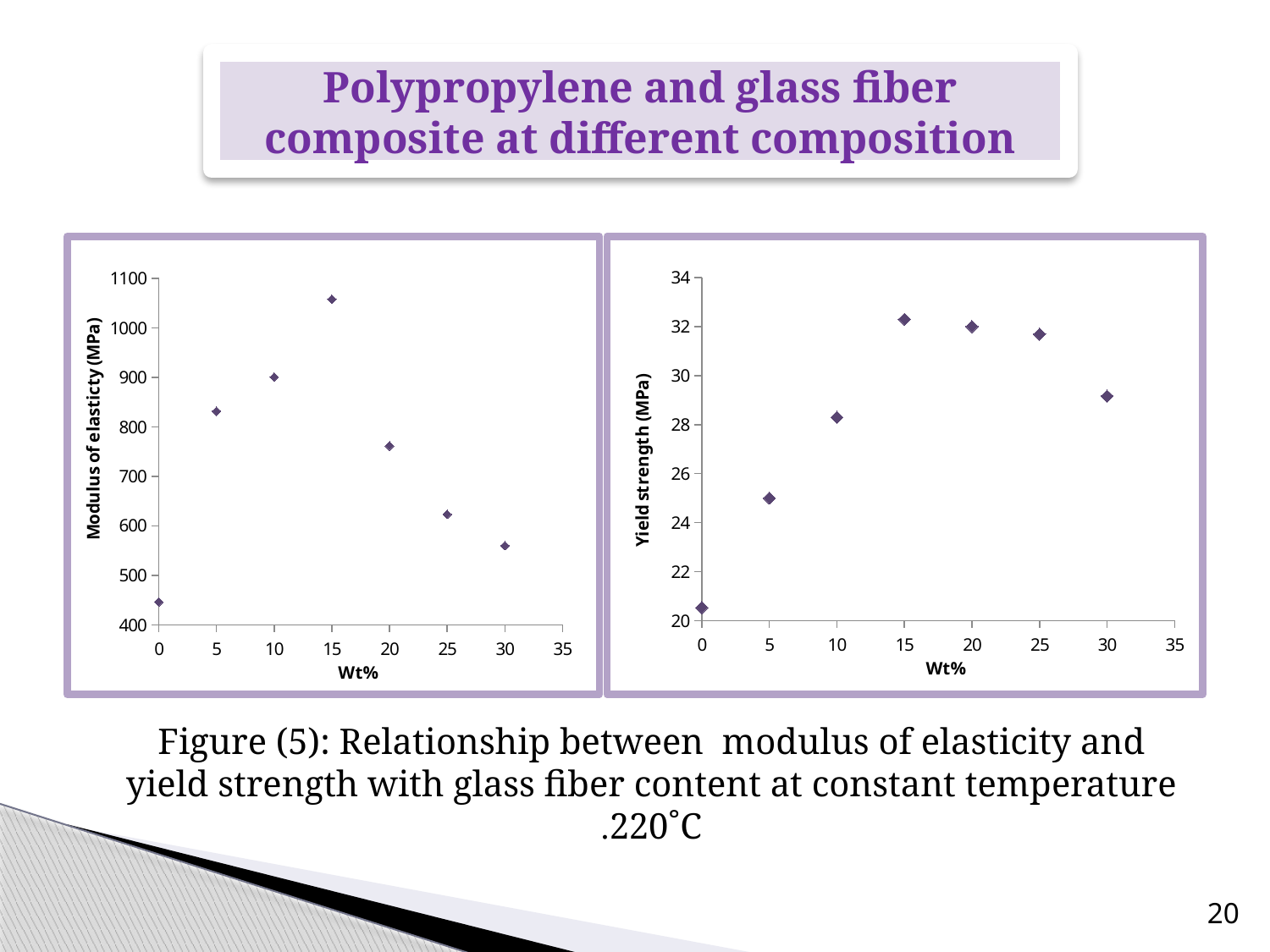
What is the y-axis label of the right chart? Yield strength (MPa) On the right chart (Yield strength vs Wt%), is the yield strength at 10 Wt% greater or less than 28? greater On the left chart (Modulus of elasticity vs Wt%), is the modulus of elasticity at 15 Wt% greater or less than 1000? greater On the left chart (Modulus of elasticity vs Wt%), at which Wt% is the modulus of elasticity highest? 15 How many data points are plotted on the left chart (Modulus of elasticity vs Wt%)? 7 On the left chart (Modulus of elasticity vs Wt%), at which Wt% is the modulus of elasticity lowest? 0 On the right chart (Yield strength vs Wt%), at which Wt% is the yield strength lowest? 0 How many data points are plotted on the right chart (Yield strength vs Wt%)? 7 What kind of chart is the left chart (Modulus of elasticity vs Wt%)? scatter chart On the left chart (Modulus of elasticity vs Wt%), is the modulus of elasticity at 30 Wt% greater or less than 600? less On the right chart (Yield strength vs Wt%), which has the larger yield strength: 15 Wt% or 30 Wt%? 15 Wt% On the left chart (Modulus of elasticity vs Wt%), does the modulus of elasticity rise or fall from 15 Wt% to 30 Wt%? fall